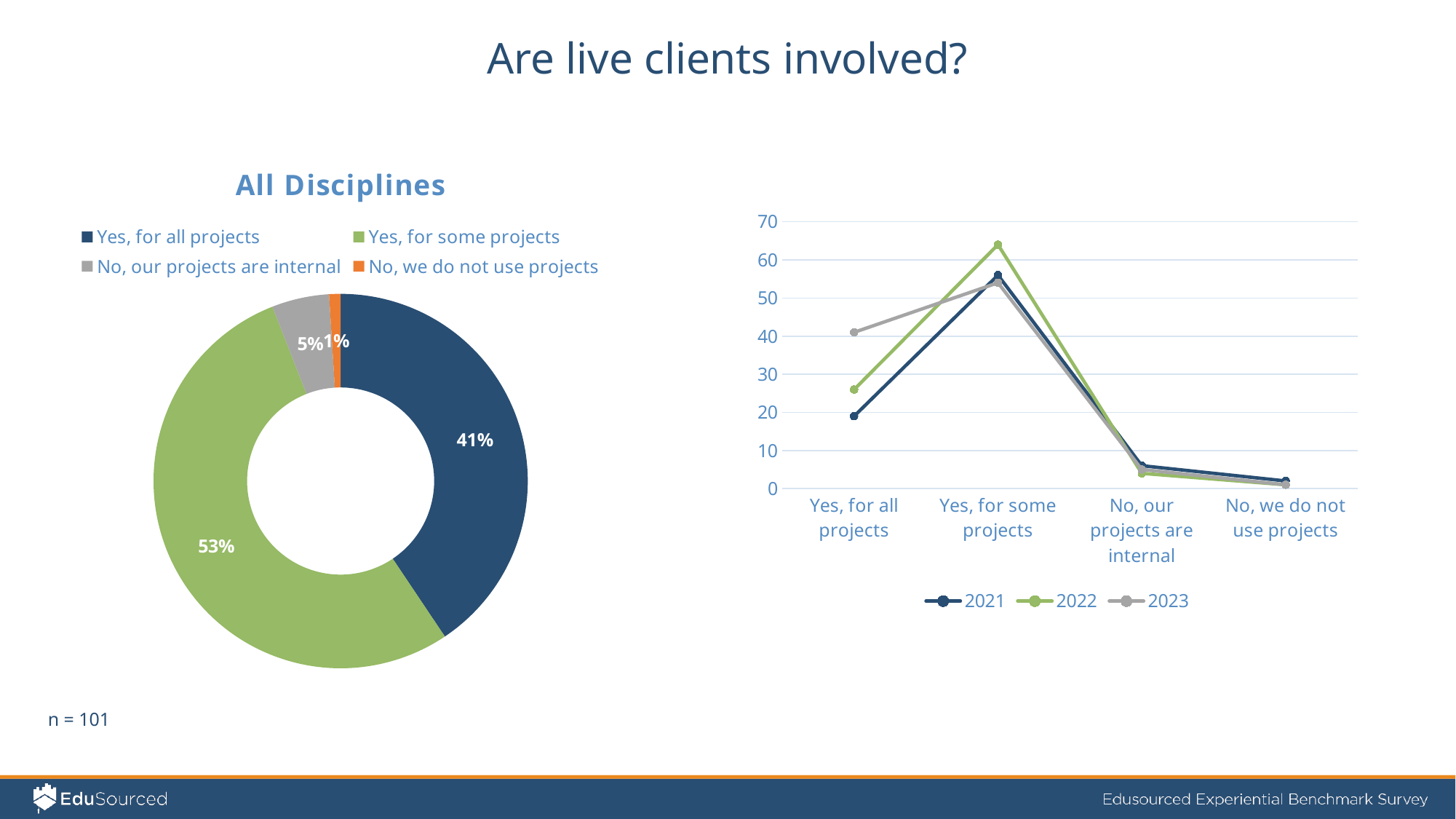
In the All Disciplines donut chart, which category has the smallest share? No, we do not use projects In the All Disciplines donut chart, which category has the largest share? Yes, for some projects In the All Disciplines donut chart, what percentage is shown for "No, our projects are internal"? 5% In the line chart on the right, is the 2022 value for "Yes, for some projects" greater or less than 60? greater In the All Disciplines donut chart, what is the difference in percentage points between "Yes, for some projects" and "Yes, for all projects"? 12 In the line chart on the right, how many series does the legend list? 3 In the All Disciplines donut chart, what percentage is shown for "Yes, for all projects"? 41% In the line chart on the right, at which category does the 2022 series reach its highest value? Yes, for some projects In the All Disciplines donut chart, how many categories are shown? 4 In the All Disciplines donut chart, what percentage is shown for "Yes, for some projects"? 53% What kind of chart is the chart on the right side of the slide? Line chart In the line chart on the right, for "Yes, for all projects", which series has the higher value: 2021 or 2023? 2023